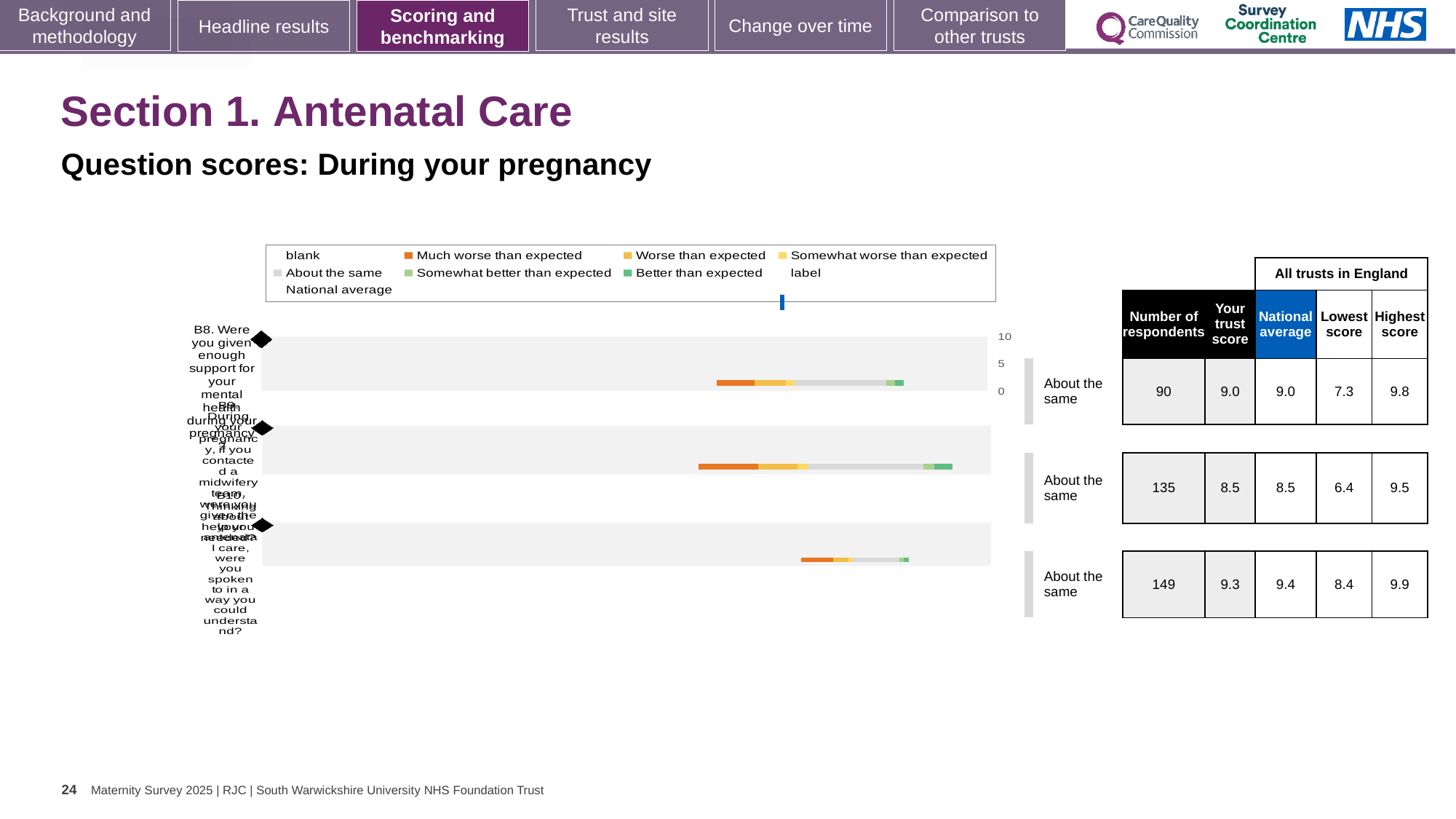
In the table beside the chart, is the trust score for the third question (B10) larger or smaller than its national average? smaller What kind of chart is shown on the slide? bar chart Which colour does the legend use for 'Much worse than expected'? orange In the table beside the chart, what is the highest score for the second question (B9)? 9.5 In the table beside the chart, what is the number of respondents for the first question (B8, support for your mental health during pregnancy)? 90 In the table beside the chart, what is the difference between the highest score and the lowest score for the first question (B8)? 2.5 Which colour does the legend use for 'Better than expected'? green In the table beside the chart, what is the trust score for the first question (B8)? 9.0 In the table beside the chart, which question has the highest number of respondents? the third question (B10), 149 In the table beside the chart, what is the national average for the second question (B9)? 8.5 In the table beside the chart, what is the lowest score for the third question (B10)? 8.4 How many question bars are plotted in the chart? 3